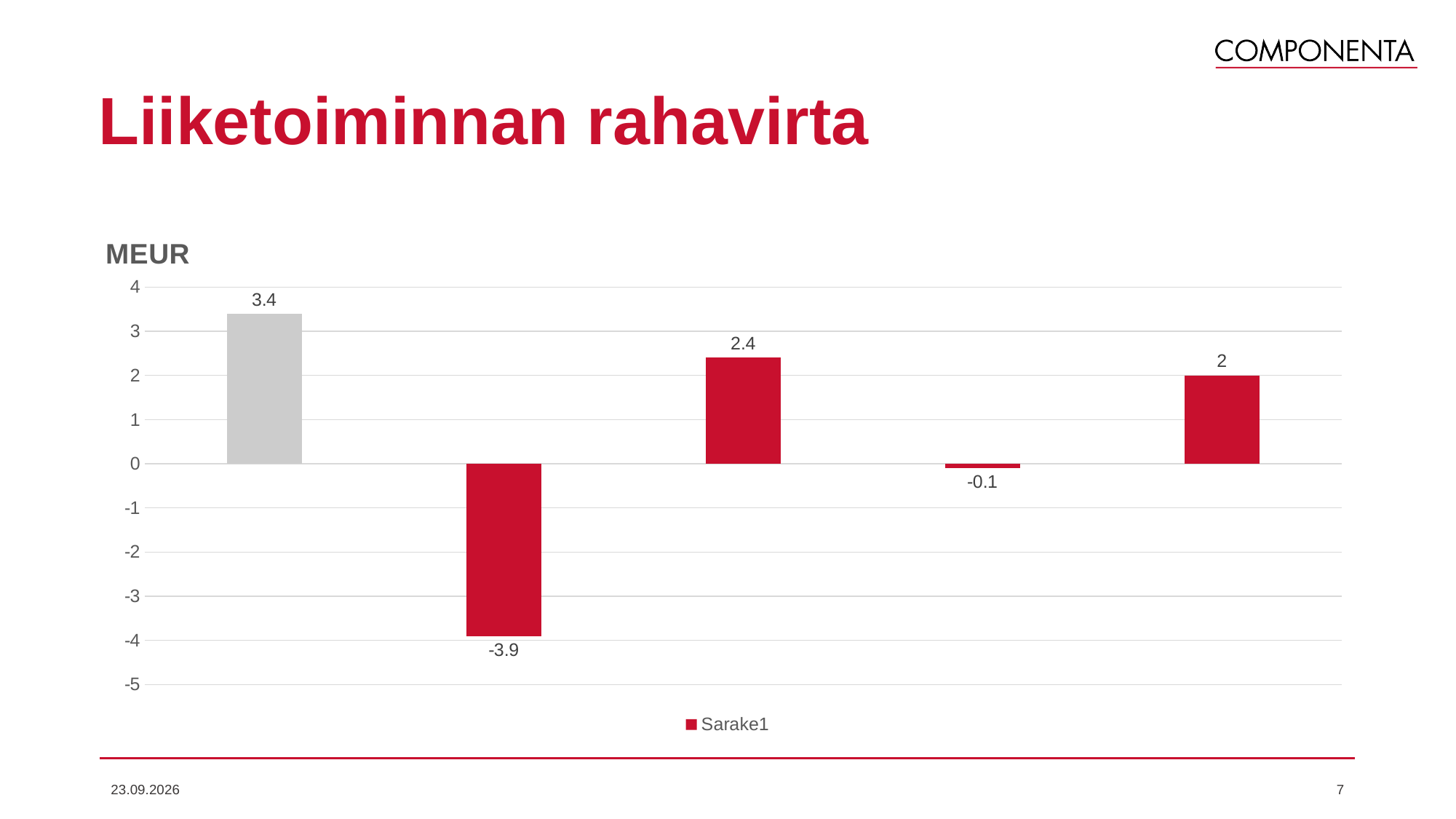
What is the value of the second bar from the left? -3.9 What is the value of the third bar from the left? 2.4 What series name is listed in the legend? Sarake1 Which is larger, the third bar or the fifth bar? the third bar (2.4) What is the value of the first (leftmost) bar? 3.4 What is the value of the last (rightmost) bar? 2 Which bar has the lowest value? the second bar from the left, -3.9 What is the difference between the first bar (3.4) and the third bar (2.4)? 1 Which bar has the highest value? the first (leftmost) bar, 3.4 What type of chart is shown on the slide? bar chart How many bars are plotted in the chart? 5 What is the value of the fourth bar from the left? -0.1